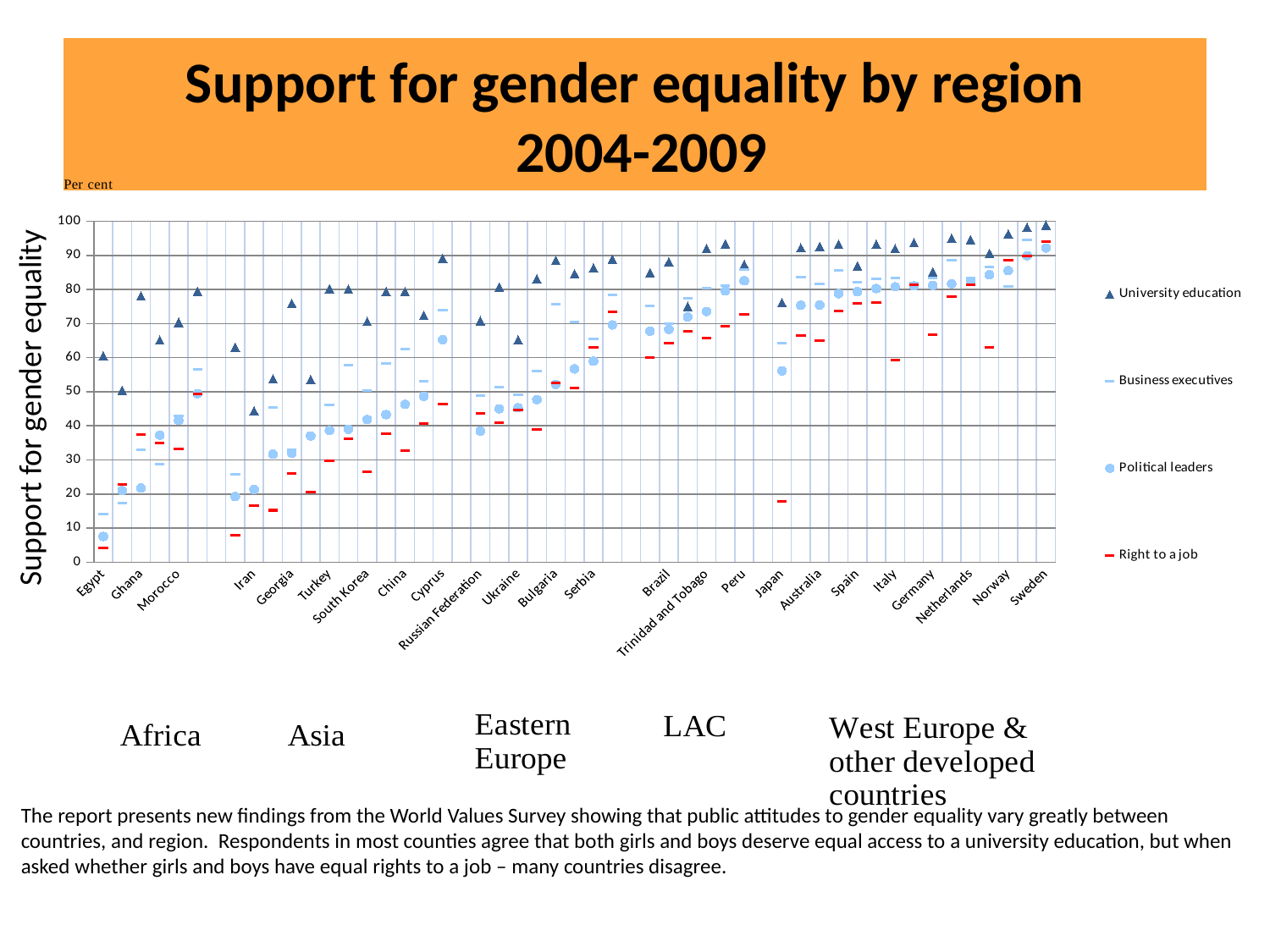
Do the University education values generally rise or fall from left to right across the countries? rise Is the University education value for Sweden greater or less than 90? greater Is the Political leaders value for Japan greater or less than 50? greater Is the Political leaders value for Egypt greater or less than 10? less What is the title of the chart on the slide? Support for gender equality by region 2004-2009 What kind of chart is shown on the slide? scatter chart How many series does the chart legend list? 4 Which country has the lowest Right to a job value? Egypt Which is larger for Japan: the University education value or the Political leaders value? University education